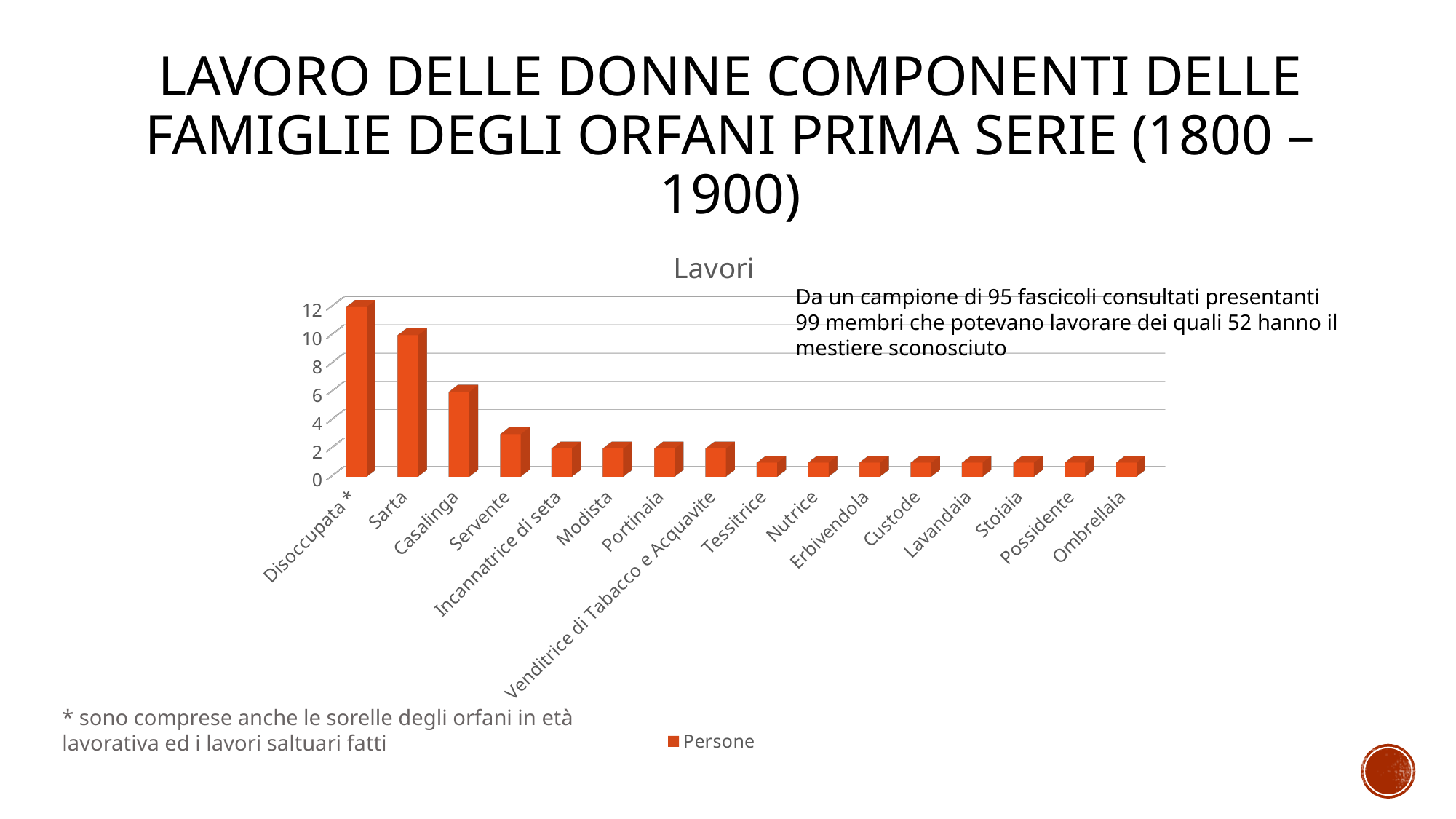
How many series does the legend list? 1 What kind of chart is shown on the slide? Bar chart Is the value for Disoccupata * greater or less than 10? greater What is the title of the chart? Lavori Which is larger, the value for Sarta or the value for Casalinga? Sarta Which category has the highest value in the chart? Disoccupata * Do the values generally rise or fall moving from left to right along the x axis? Fall Is the value for Servente greater or less than 4? less Is the value for Casalinga greater or less than 4? greater How many categories are shown on the x axis of the chart? 16 What is the name of the series in the legend? Persone